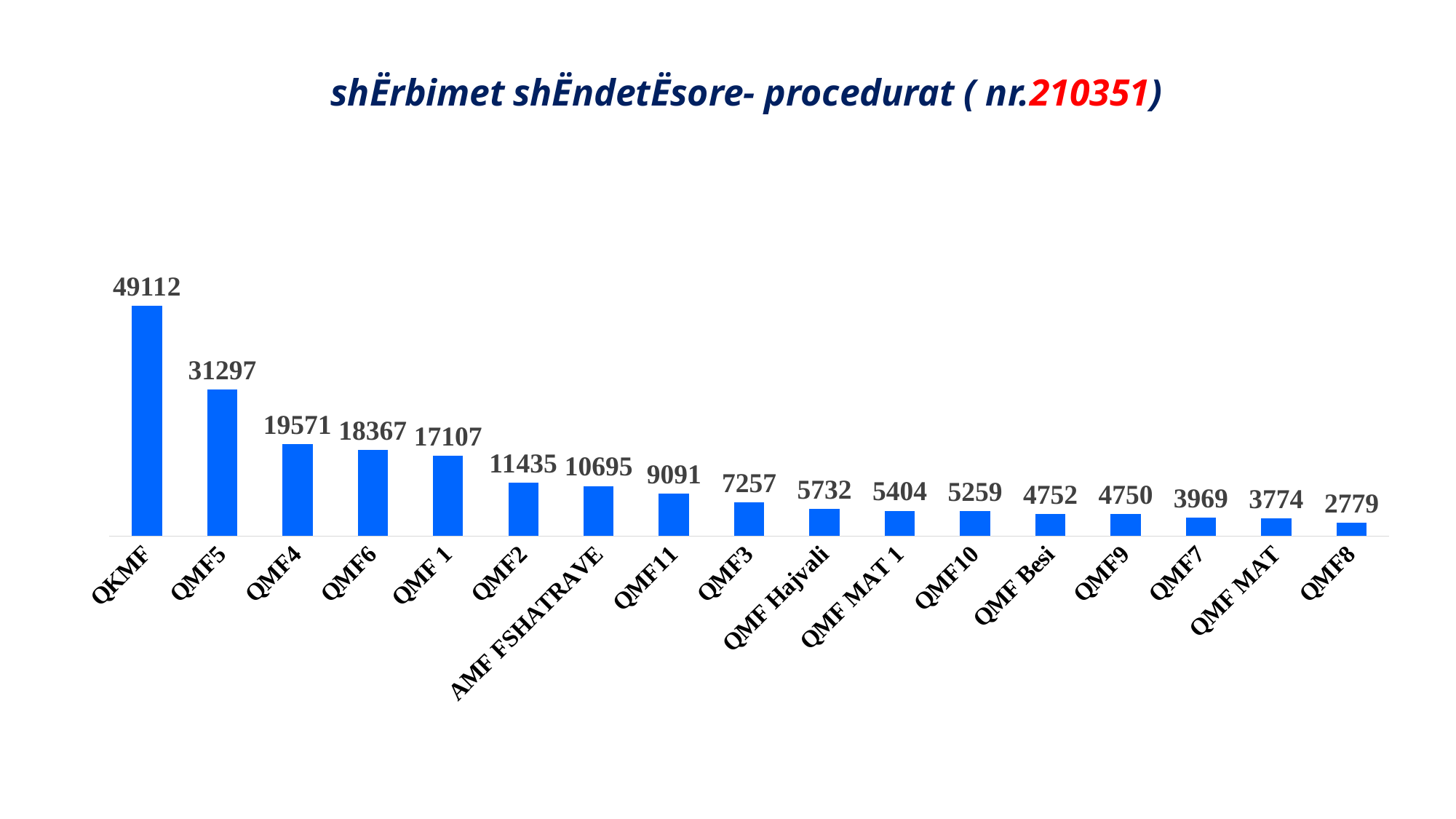
What is the difference between the values for QMF4 and QMF6? 1204 What kind of chart is shown on the slide? Bar chart Which category has the lowest value? QMF8 How many categories are shown in the chart? 17 What is the value for QKMF? 49112 What is the value for QMF Hajvali? 5732 What is the difference between the values for QKMF and QMF5? 17815 Which is larger, the value for QMF2 or the value for QMF11? QMF2 What is the value for QMF MAT? 3774 What is the value for AMF FSHATRAVE? 10695 Do the values rise or fall from left to right along the x axis? Fall Which category has the highest value? QKMF